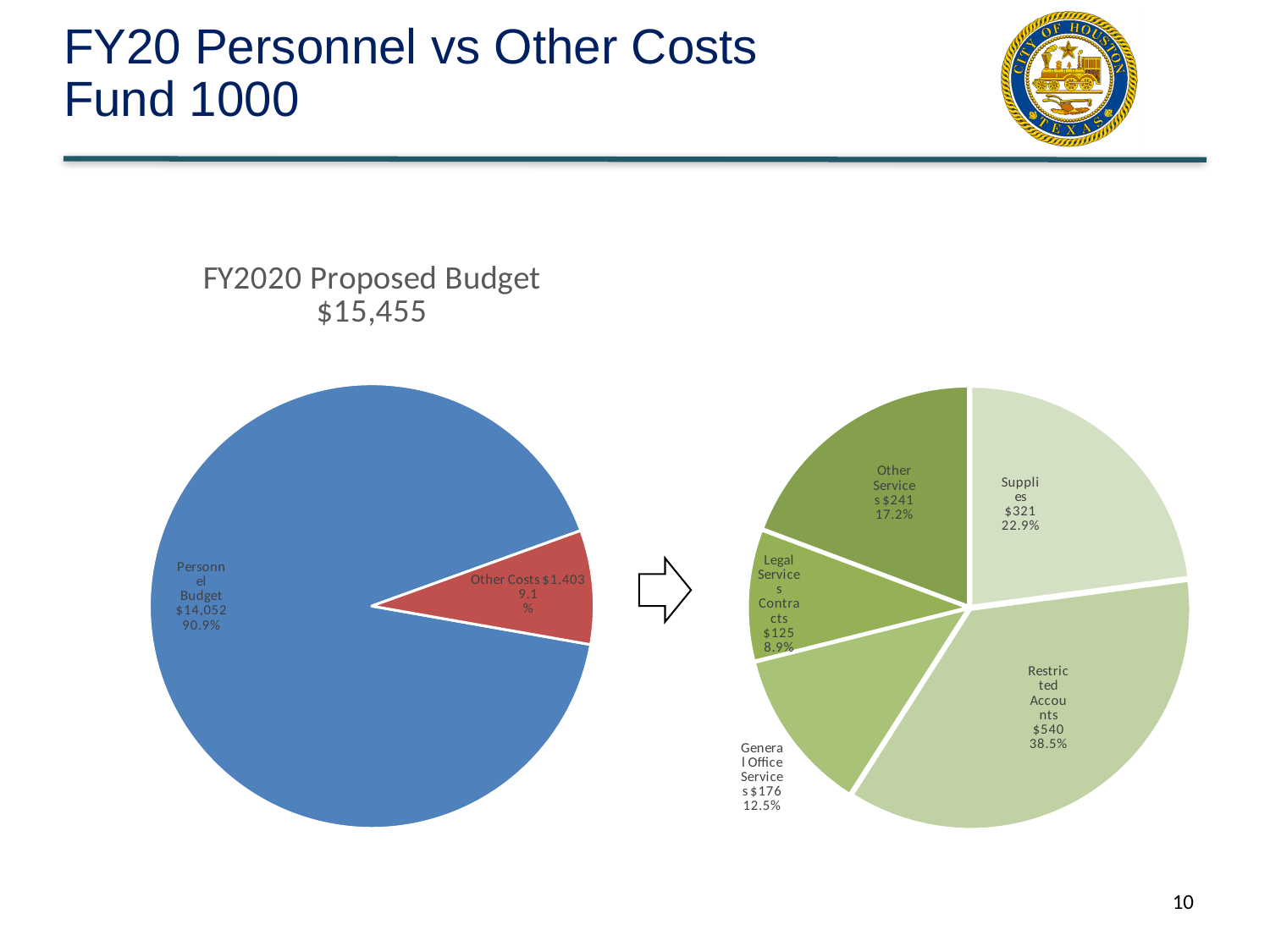
In the FY2020 Proposed Budget pie chart on the left, what share of the pie is Other Costs? 9.1% What kind of chart is the chart on the left of the slide? Pie chart In the pie chart on the right, what is the difference between the values for Other Services and General Office Services? $65 In the pie chart on the right, what share of the pie is Supplies? 22.9% In the pie chart on the right, what is the value for Restricted Accounts? $540 In the FY2020 Proposed Budget pie chart on the left, what is the value for Other Costs? $1,403 In the pie chart on the right, which is larger: Supplies or Other Services? Supplies In the pie chart on the right, which category has the smallest slice? Legal Services Contracts In the FY2020 Proposed Budget pie chart on the left, what is the value for Personnel Budget? $14,052 In the FY2020 Proposed Budget pie chart on the left, how many slices are there? 2 In the pie chart on the right, how many categories are shown? 5 In the pie chart on the right, which category has the largest slice? Restricted Accounts